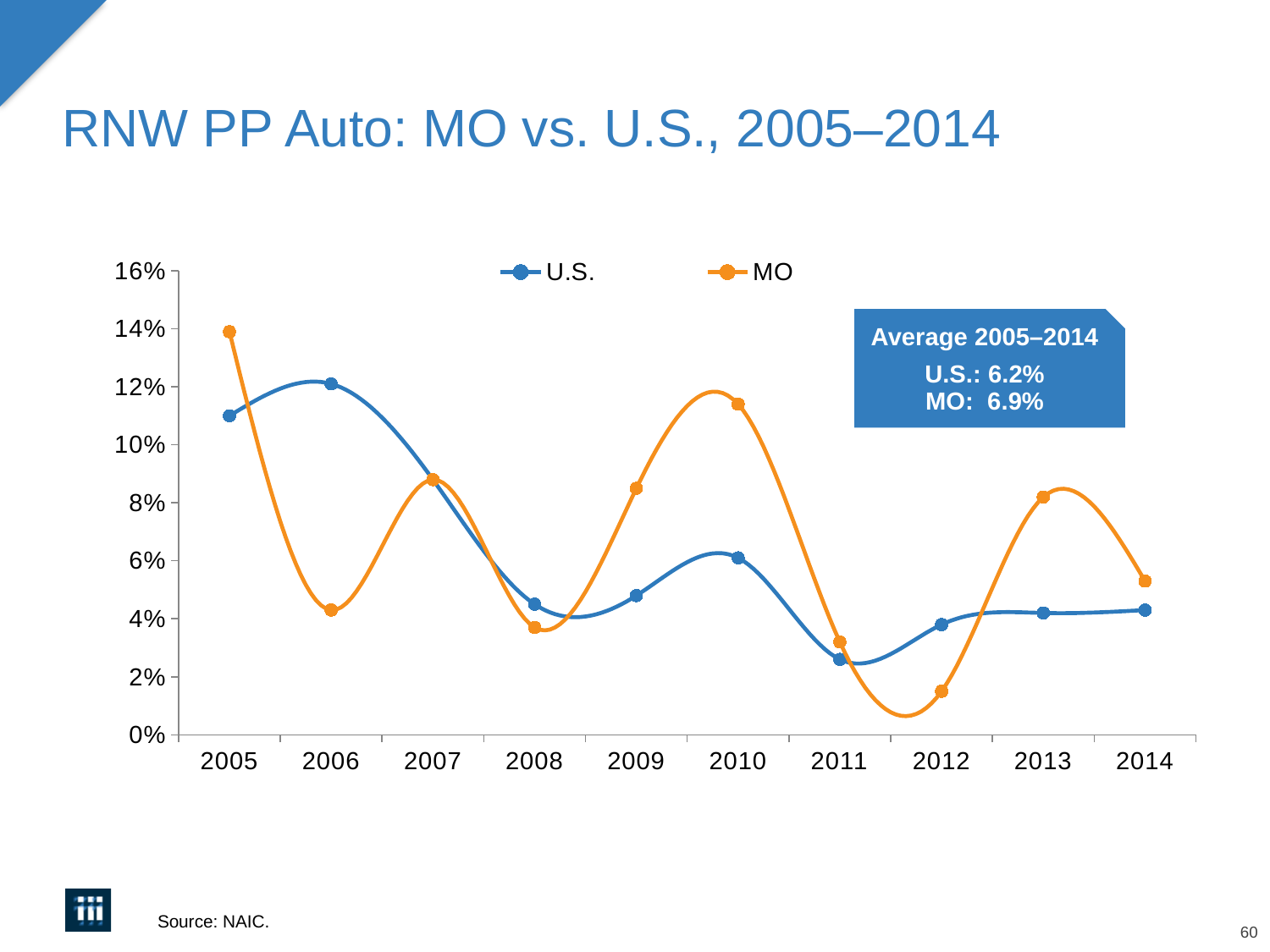
In which year is the U.S. value lowest? 2011 What is the average RNW for the U.S. over 2005–2014, as shown in the text box? 6.2% Is the U.S. value for 2012 greater or less than 6%? less In which year is the MO value highest? 2005 How many series does the legend list? 2 Is the MO value for 2010 greater or less than 10%? greater How many years are plotted along the x axis? 10 In which year is the MO value lowest? 2012 By how many percentage points does the MO average for 2005–2014 exceed the U.S. average? 0.7 percentage points What is the average RNW for MO over 2005–2014, as shown in the text box? 6.9% What type of chart is shown on the slide? Line chart In 2005, which series has the higher value, U.S. or MO? MO